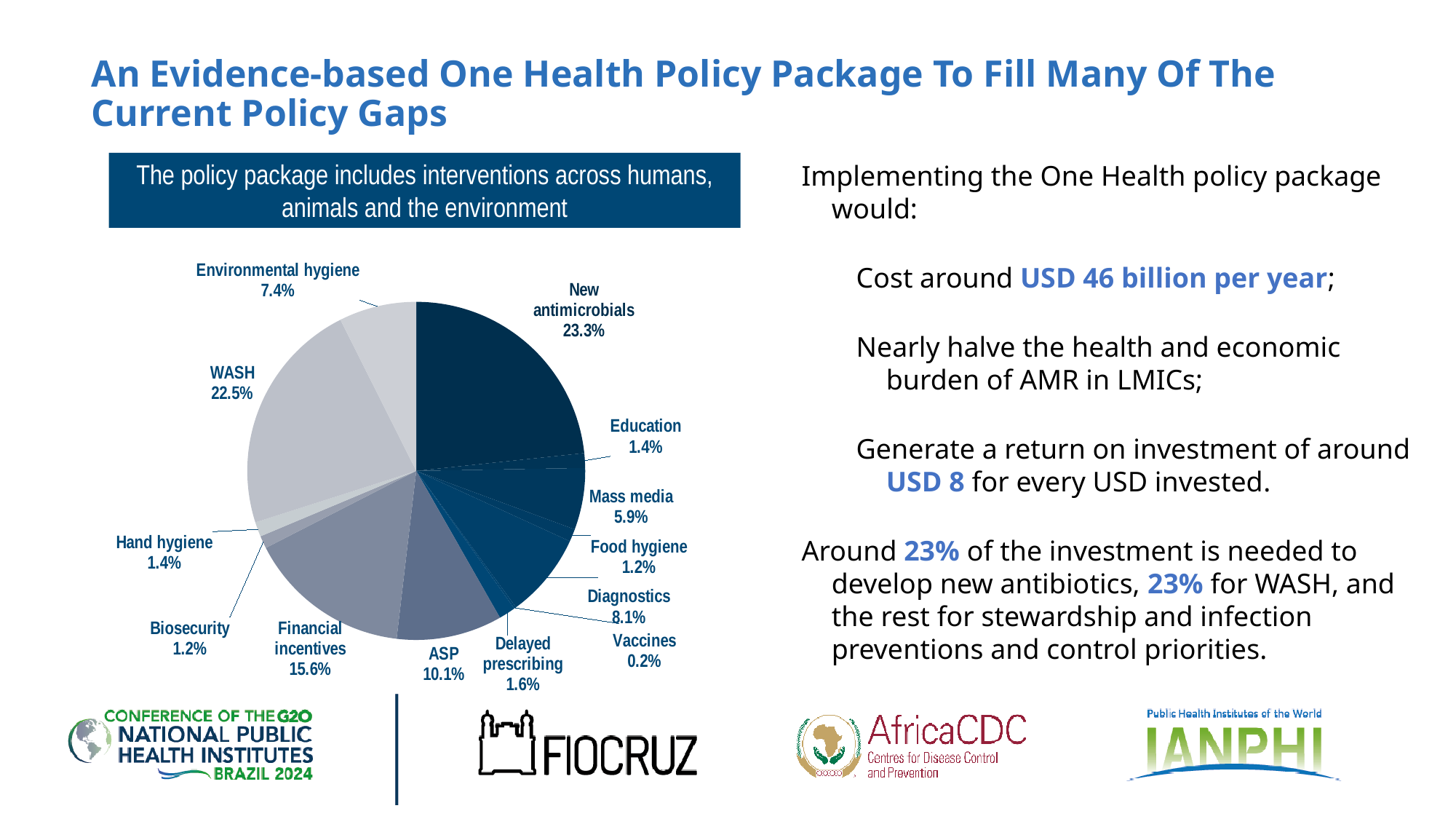
What kind of chart is shown on the slide? Pie chart What is the value shown for WASH? 22.5% Which is larger, the share for ASP or the share for Mass media? ASP What share of the pie does New antimicrobials account for? 23.3% Which category has the smallest slice of the pie? Vaccines What is the value shown for Financial incentives? 15.6% How many categories are shown in the pie chart? 13 What is the value shown for Delayed prescribing? 1.6% What is the difference between the shares for Financial incentives and ASP? 5.5% What is the difference between the shares for New antimicrobials and WASH? 0.8% Which category has the largest slice of the pie? New antimicrobials What is the value shown for Diagnostics? 8.1%